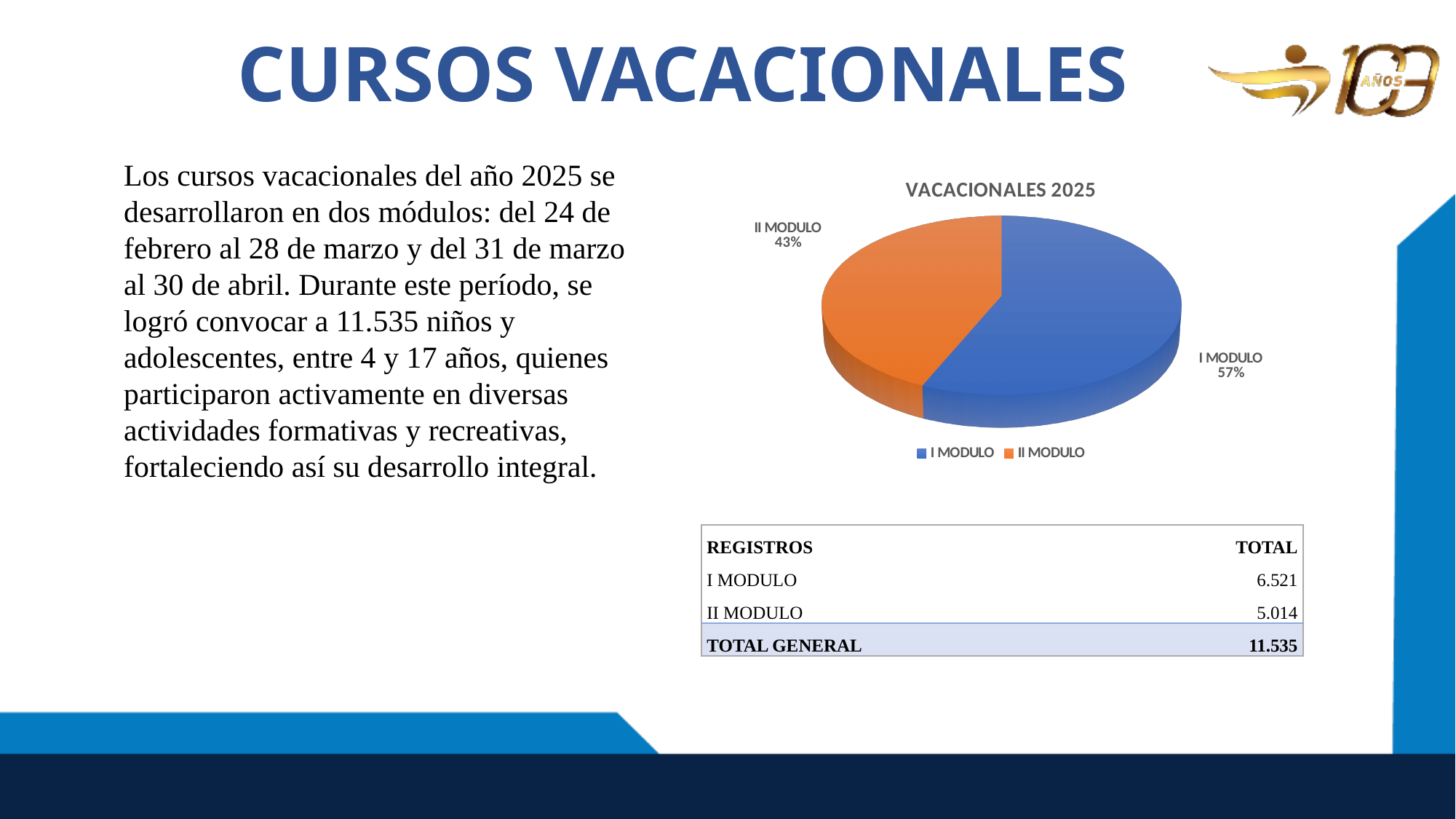
How many slices does the pie chart have? 2 Which slice is larger, I MODULO or II MODULO? I MODULO Which module has the smallest slice of the pie? II MODULO Which module has the largest slice of the pie? I MODULO What is the title of the pie chart? VACACIONALES 2025 What share of the pie does I MODULO represent? 57% What colour is the II MODULO slice in the pie chart? orange What kind of chart is shown on the slide? pie chart What share of the pie does II MODULO represent? 43% How many entries does the legend of the pie chart list? 2 According to the table below the chart, what is the total for I MODULO? 6.521 By how many percentage points does the I MODULO share exceed the II MODULO share? 14 percentage points